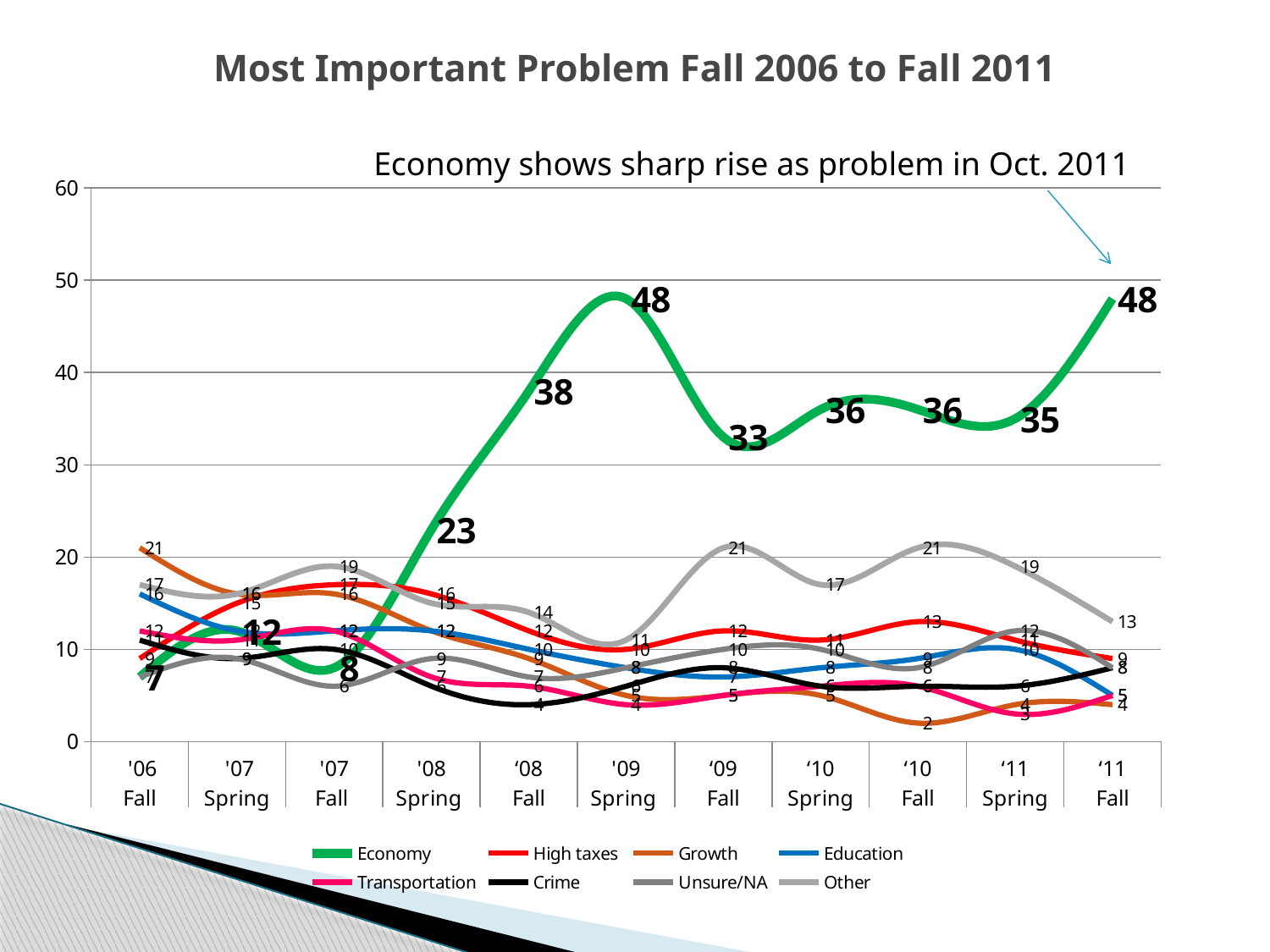
What kind of chart is shown on the slide? line chart What is the value for Growth in '06 Fall? 21 What is the value for Economy in '09 Spring? 48 What is the value for Other in '11 Fall? 13 What is the difference between the Economy values in '08 Fall and '08 Spring? 15 In which period is the Economy value lowest? '06 Fall What is the value for Economy in '09 Fall? 33 What is the value for Economy in '08 Fall? 38 Does the Economy line rise or fall from '07 Fall to '09 Spring? rise How many series does the legend list? 8 Which is larger, the Economy value in '08 Fall or in '09 Fall? '08 Fall How many time periods are shown along the x axis? 11